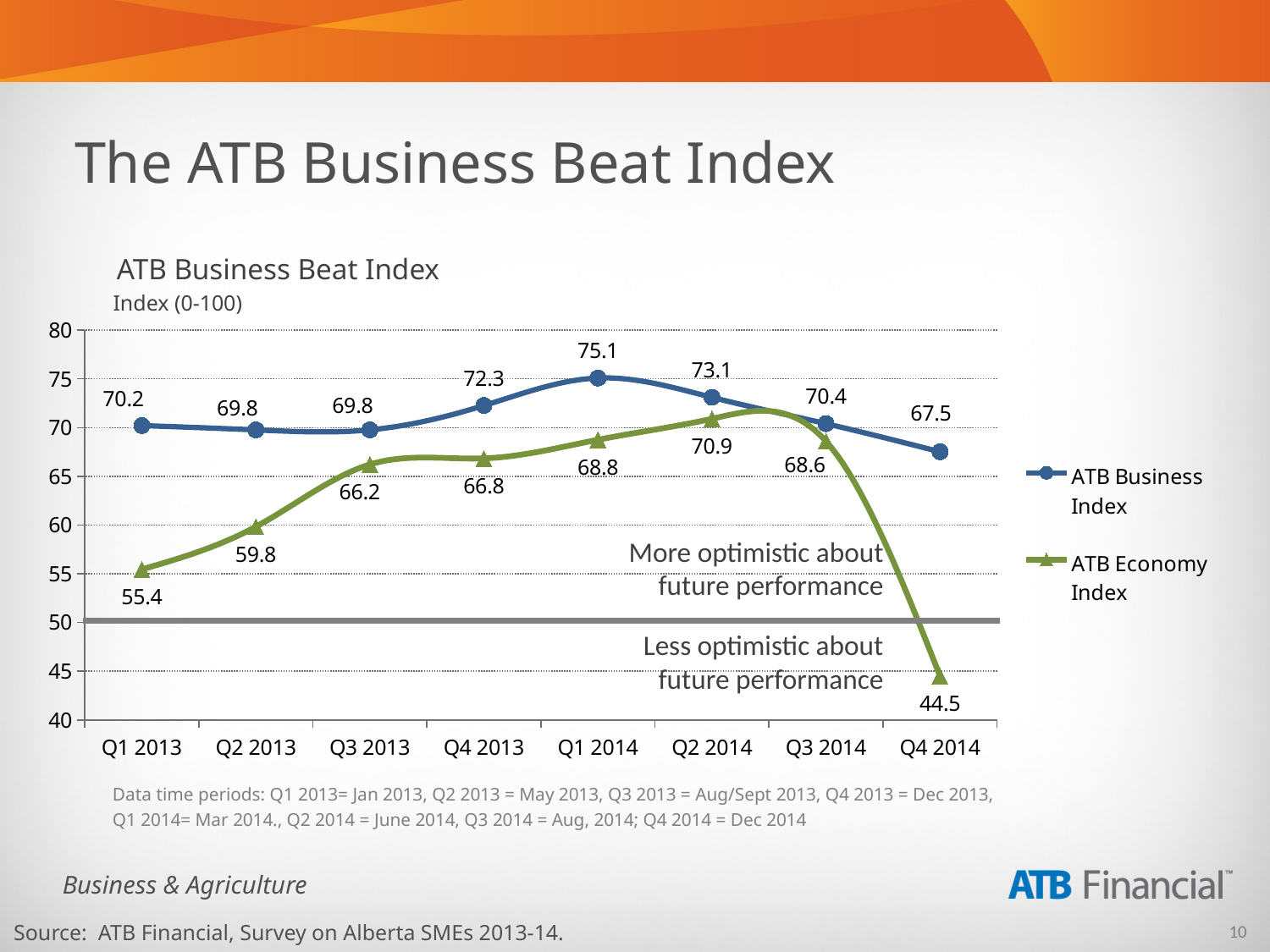
What type of chart is shown on the slide? Line chart In which quarter is the ATB Economy Index at its highest? Q2 2014 Is the ATB Economy Index value for Q4 2014 greater or less than 50? less What is the value of the ATB Economy Index in Q4 2014? 44.5 What is the title of the chart? ATB Business Beat Index Does the ATB Economy Index rise or fall from Q1 2013 to Q2 2014? Rise How many series does the legend list? 2 In which quarter is the ATB Business Index at its lowest? Q4 2014 How many quarters are plotted along the x axis? 8 What is the value of the ATB Business Index in Q1 2014? 75.1 Which is larger in Q3 2014, the ATB Business Index or the ATB Economy Index? ATB Business Index What is the difference between the ATB Business Index and the ATB Economy Index in Q1 2013? 14.8